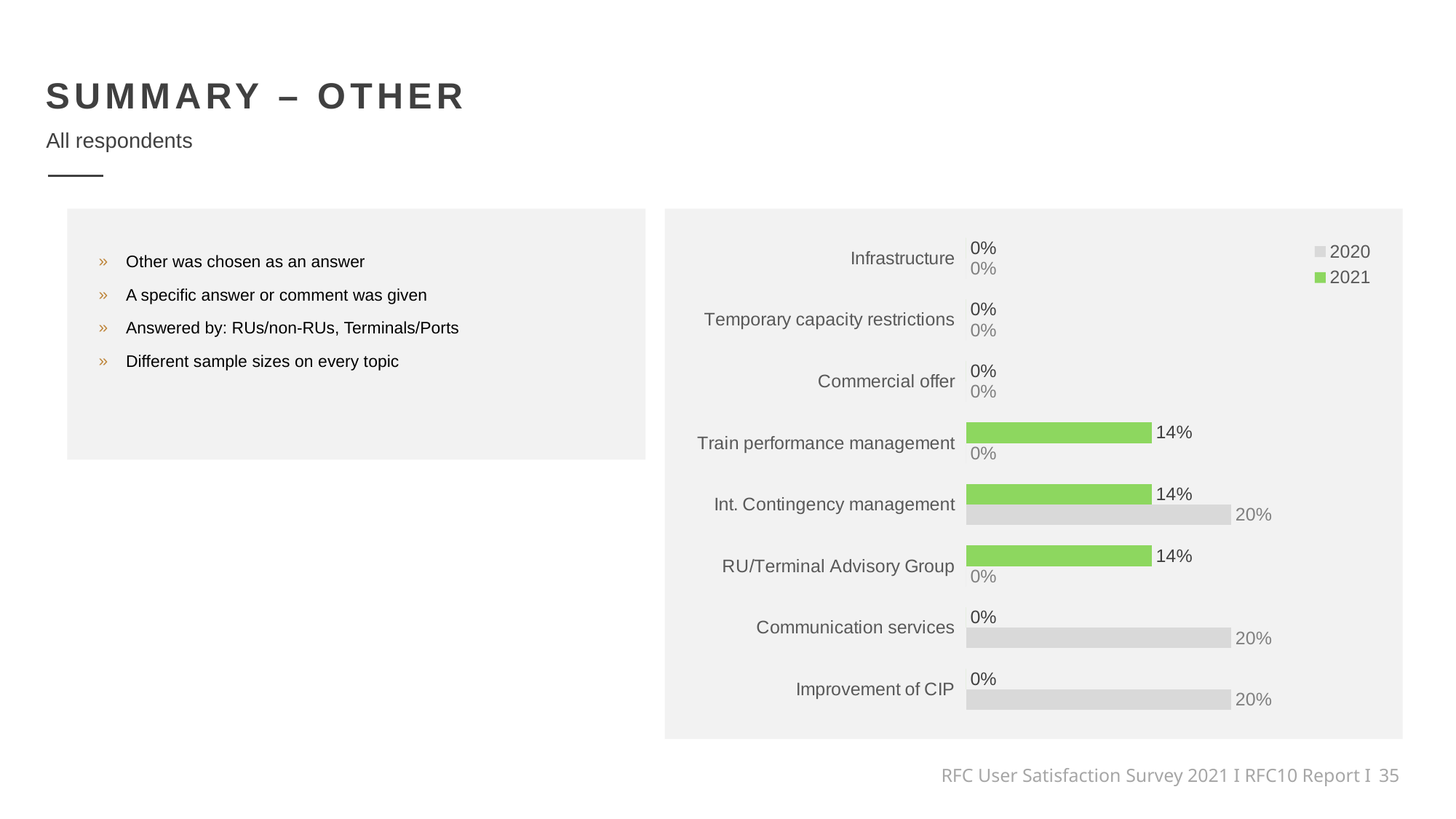
How many categories are shown in the chart? 8 What is the 2020 value for Communication services? 20% Which colour represents the 2021 series in the chart? Green What is the 2021 value for Improvement of CIP? 0% For Int. Contingency management, which year has the larger value, 2020 or 2021? 2020 What is the difference between the 2020 and 2021 values for Int. Contingency management? 6% What kind of chart is shown on the slide? Bar chart What is the 2020 value for Train performance management? 0% What is the 2020 value for Int. Contingency management? 20% What is the 2021 value for RU/Terminal Advisory Group? 14% How many series does the legend list? 2 What is the 2021 value for Train performance management? 14%